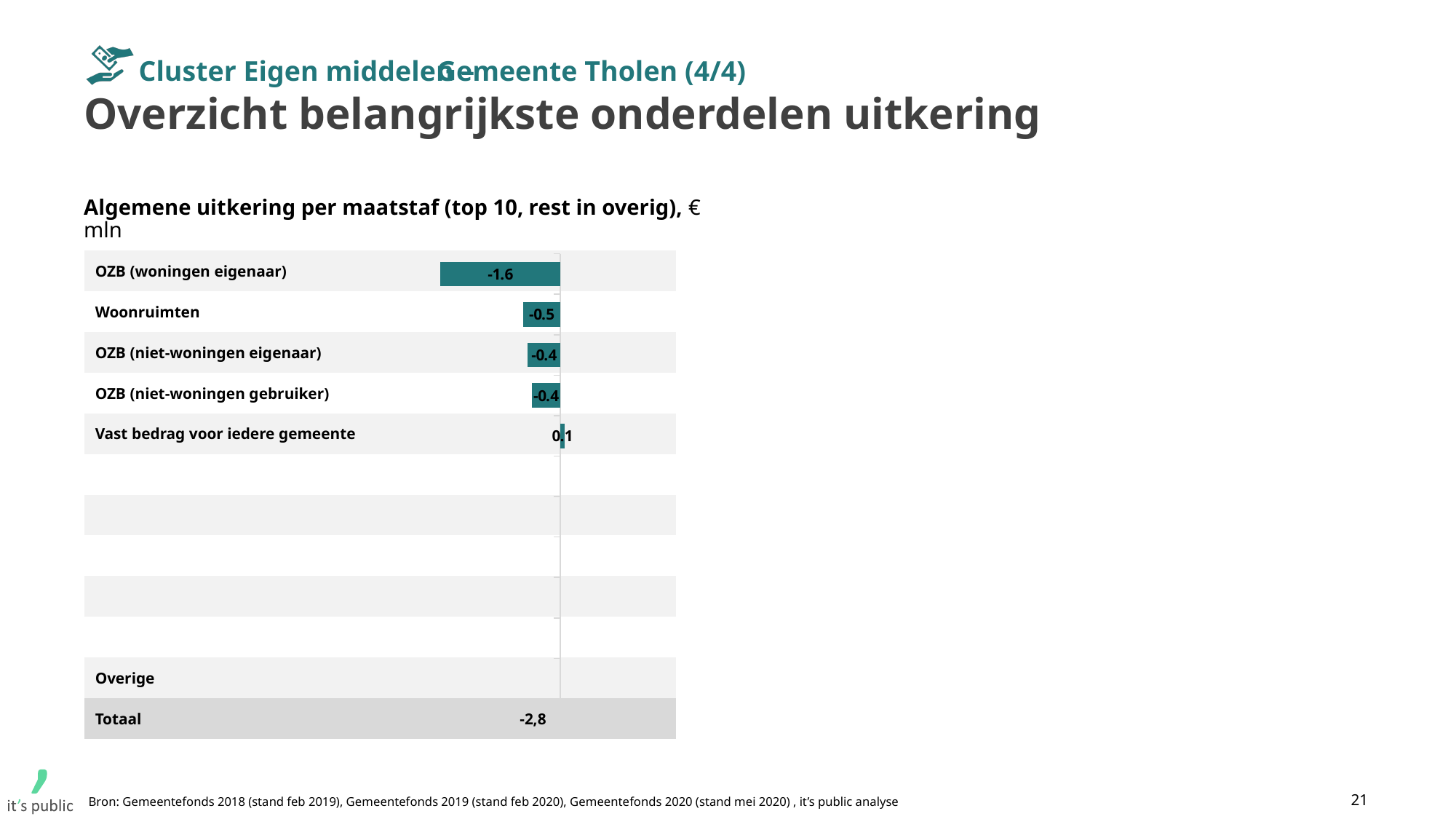
What is the value for Vast bedrag voor iedere gemeente? 0.1 Which category has the lowest (most negative) value? OZB (woningen eigenaar) What kind of chart is shown on the slide? Bar chart What is the value for OZB (niet-woningen eigenaar)? -0.4 What is the difference between the values for OZB (woningen eigenaar) and Woonruimten? 1.1 Which category has the highest value? Vast bedrag voor iedere gemeente Which is larger, the value for Woonruimten or the value for OZB (niet-woningen gebruiker)? OZB (niet-woningen gebruiker) What is the title of the chart? Algemene uitkering per maatstaf (top 10, rest in overig), € mln What is the value for Woonruimten? -0.5 How many categories have a labelled bar value in the chart (excluding Overige and Totaal)? 5 What is the value shown for Totaal? -2,8 What is the value for OZB (woningen eigenaar)? -1.6